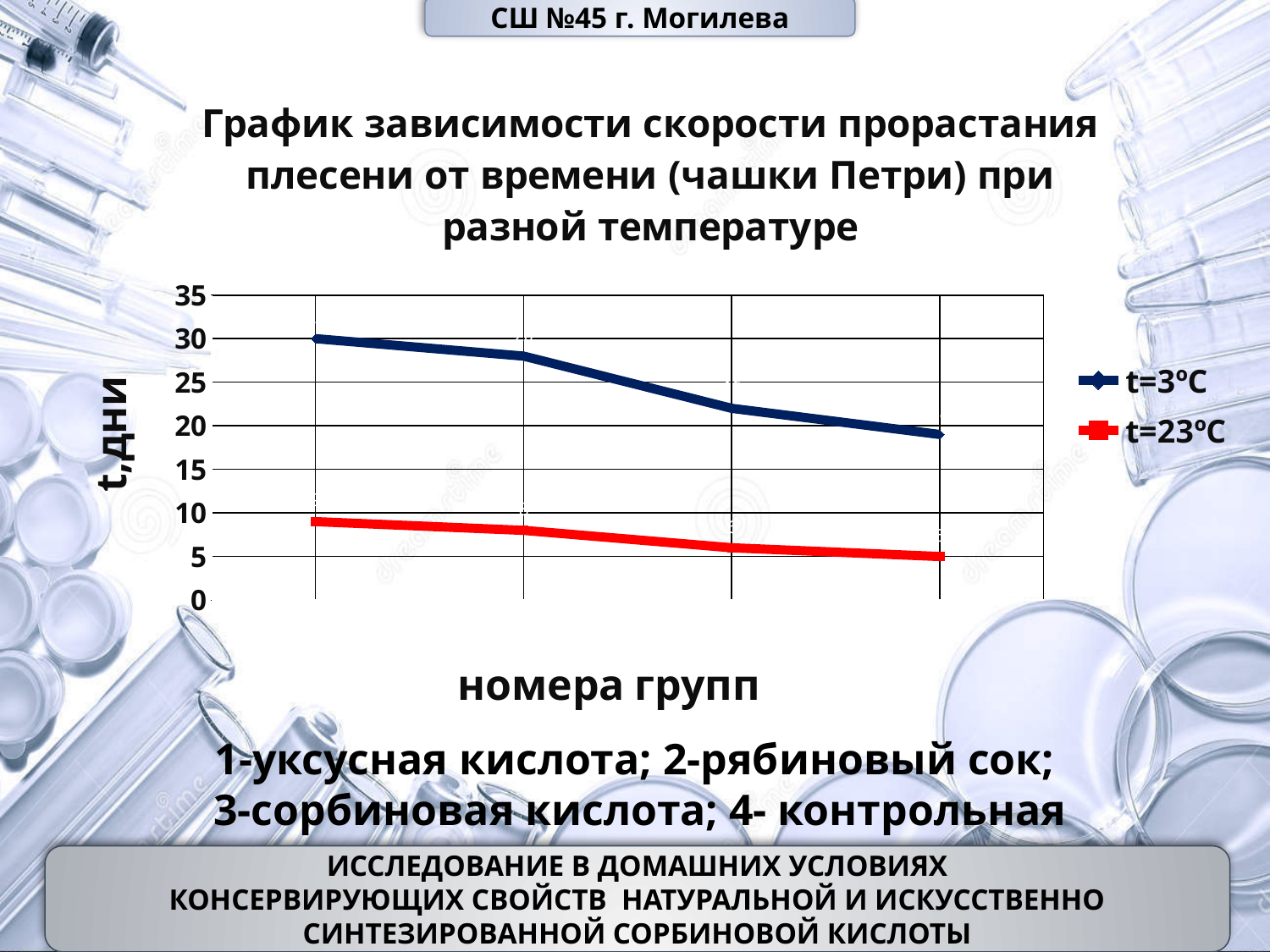
Is the first value of the t=3°C line greater or less than 25? greater How many data points does each line have? 4 Is the last value of the t=3°C line greater or less than 25? less What kind of chart is shown on the slide? line chart How many series does the legend list? 2 Do the values of the t=23°C line rise or fall along the x axis? fall Is the last value of the t=23°C line greater or less than 10? less What colour is the t=23°C line? red Which series has higher values throughout, t=3°C or t=23°C? t=3°C What is the label of the vertical axis? t,дни Do the values of the t=3°C line rise or fall along the x axis? fall